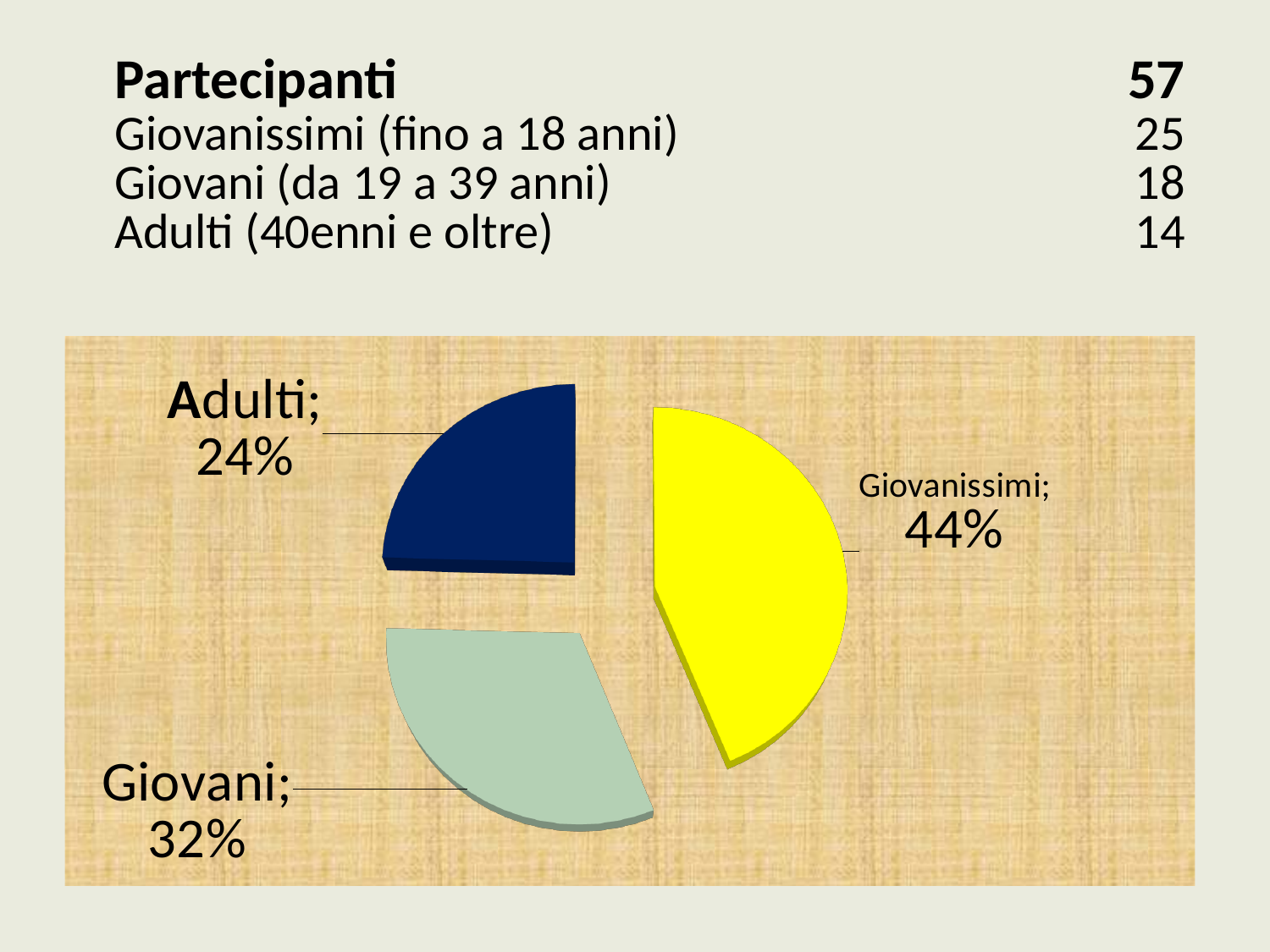
How many slices does the pie chart have? 3 Which category has the smallest slice of the pie? Adulti What share of the pie does the Giovani slice represent? 32% What is the difference in percentage points between the Giovani and Adulti slices? 8% Which category has the largest slice of the pie? Giovanissimi What kind of chart is shown on the slide? Pie chart What share of the pie does the Giovanissimi slice represent? 44% Which slice is larger, Giovani or Adulti? Giovani What colour is the Giovanissimi slice? Yellow What share of the pie does the Adulti slice represent? 24% What colour is the Adulti slice? Dark blue What is the difference in percentage points between the Giovanissimi and Adulti slices? 20%